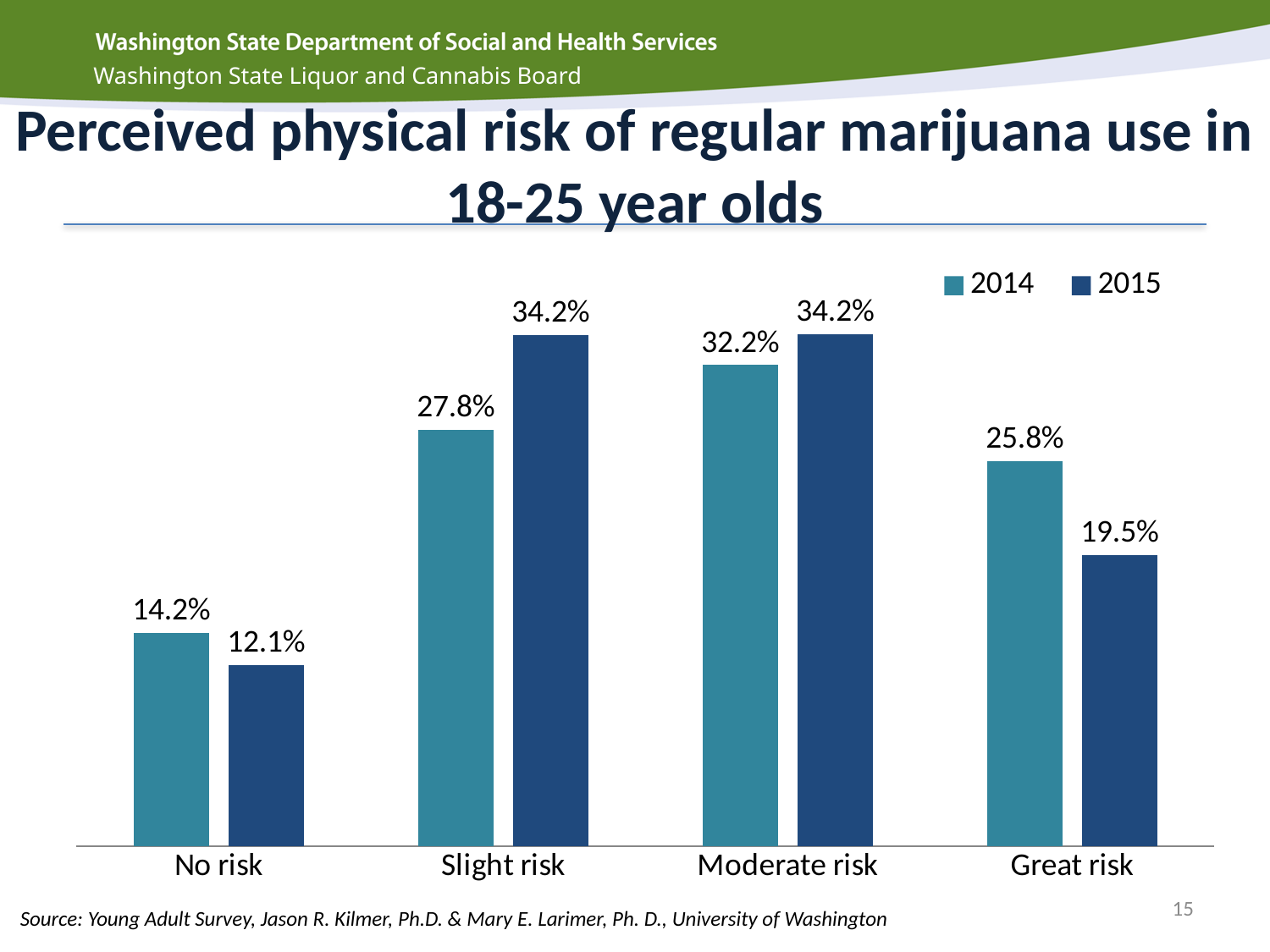
What is the 2014 value for No risk? 14.2% Which category has the lowest 2015 value? No risk What is the 2015 value for Moderate risk? 34.2% How many categories are shown on the x axis? 4 Which category has the highest 2014 value? Moderate risk What is the 2015 value for Great risk? 19.5% What is the difference between the 2015 and 2014 values for Slight risk? 6.4% Which is larger for Moderate risk, the 2014 value or the 2015 value? 2015 What is the difference between the 2014 and 2015 values for Great risk? 6.3% What kind of chart is shown on the slide? Bar chart How many series does the legend list? 2 What is the 2014 value for Slight risk? 27.8%